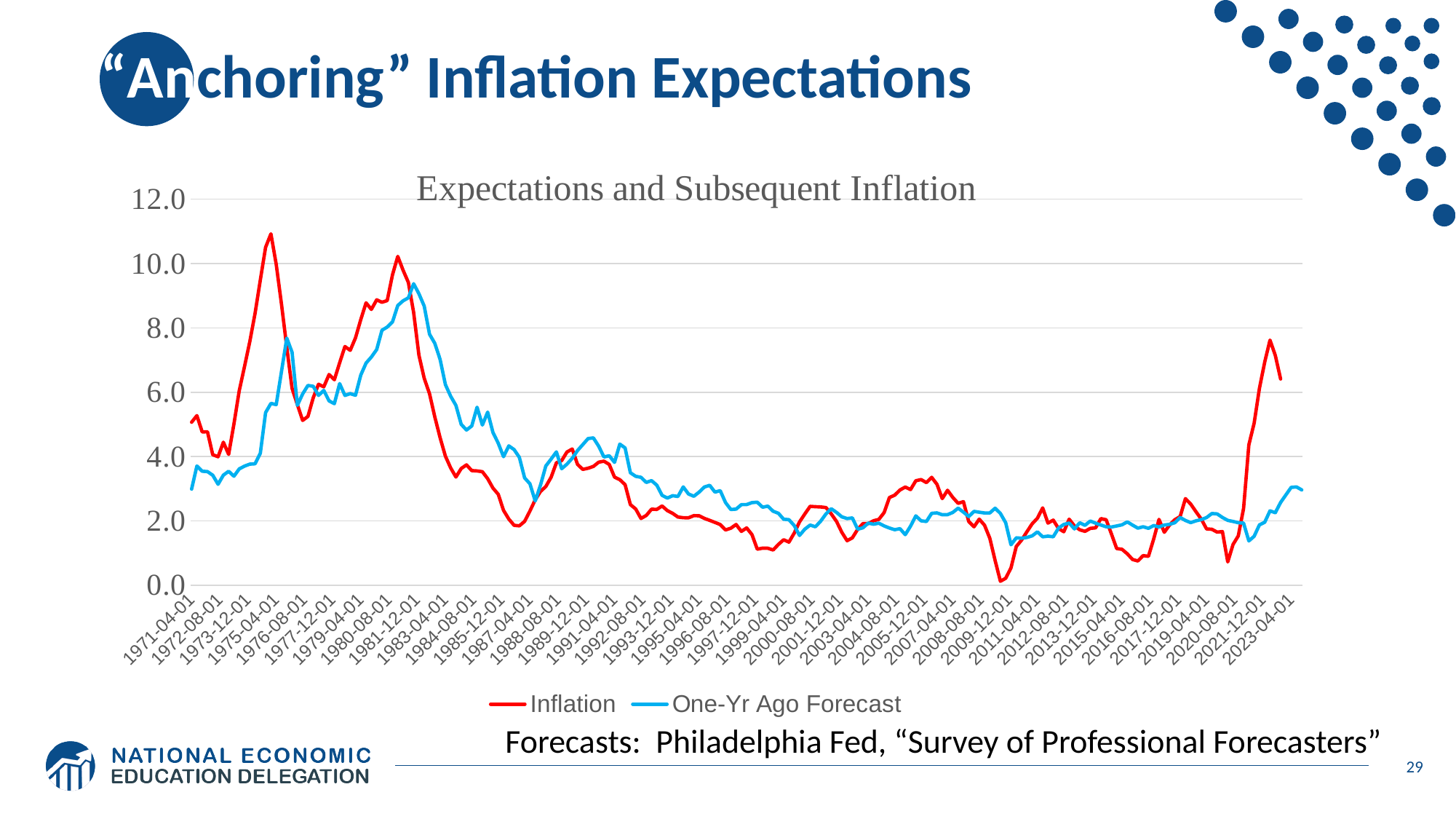
Around 2009-12-01, which series has the higher value, Inflation or One-Yr Ago Forecast? One-Yr Ago Forecast Which series reaches the highest value anywhere on the chart? Inflation Around 1975-04-01, which series has the higher value, Inflation or One-Yr Ago Forecast? Inflation What is the title of the chart? Expectations and Subsequent Inflation What kind of chart is shown on the slide? line chart How many series does the legend list? 2 Is the peak value of the One-Yr Ago Forecast series around 1981-12-01 greater or less than 10.0? less Does the Inflation series rise or fall between 1981-12-01 and 1987-04-01? fall Is the peak value of the Inflation series around 1975 greater or less than 10.0? greater Is the Inflation value around 2009-12-01 greater or less than 2.0? less Which colour is used for the One-Yr Ago Forecast series? blue